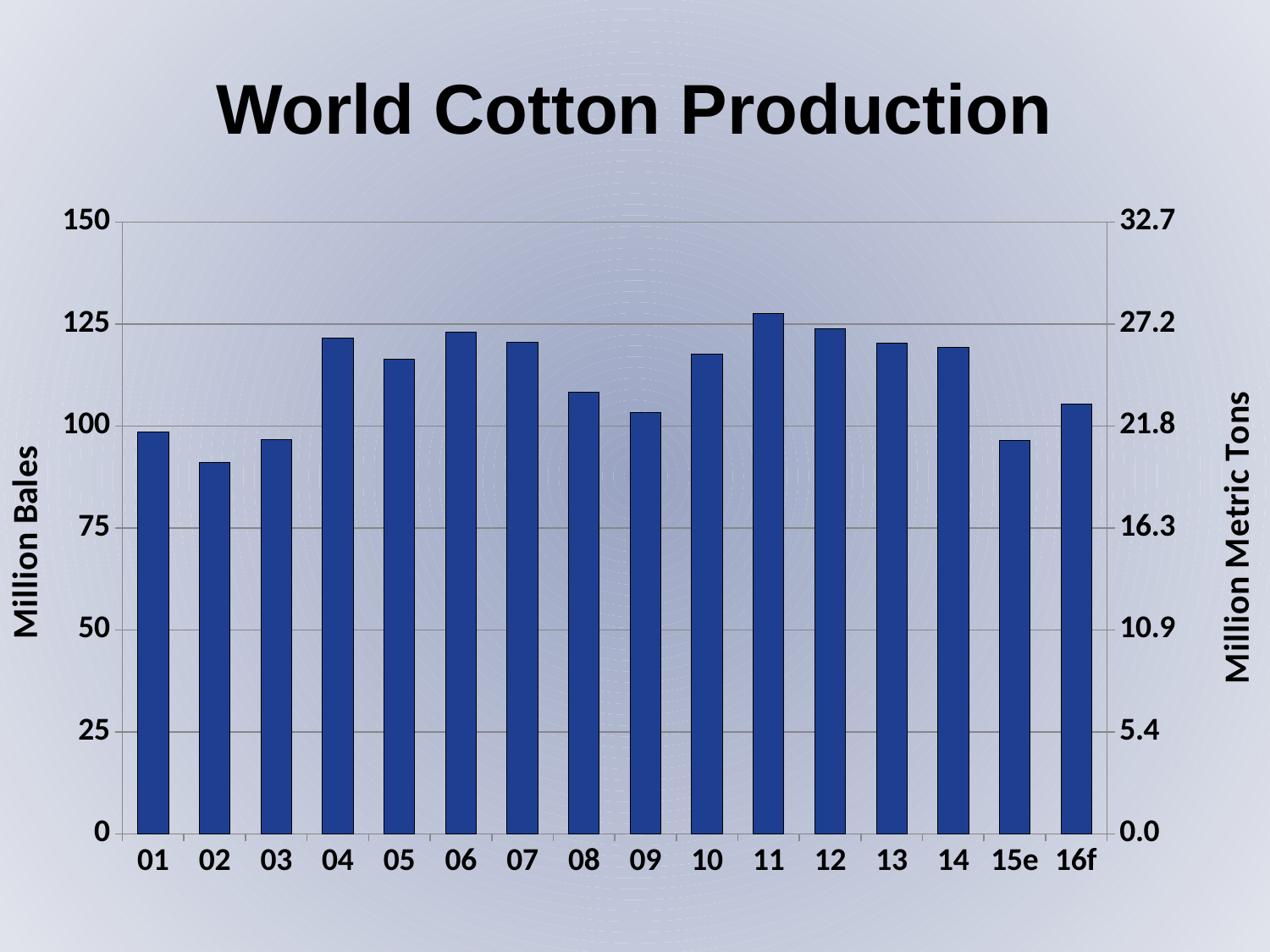
Which year has the highest world cotton production? 11 Is the value for 16f greater or less than 100 million bales? greater Which year has the lowest world cotton production? 02 What is the label of the left vertical axis? Million Bales What kind of chart is shown on the slide? bar chart Which year has the larger production, 01 or 04? 04 What is the title of the chart? World Cotton Production Do the values rise or fall from 06 to 09? fall Is the value for 15e greater or less than 100 million bales? less How many years (categories) are shown on the x axis? 16 Is the value for 02 greater or less than 100 million bales? less